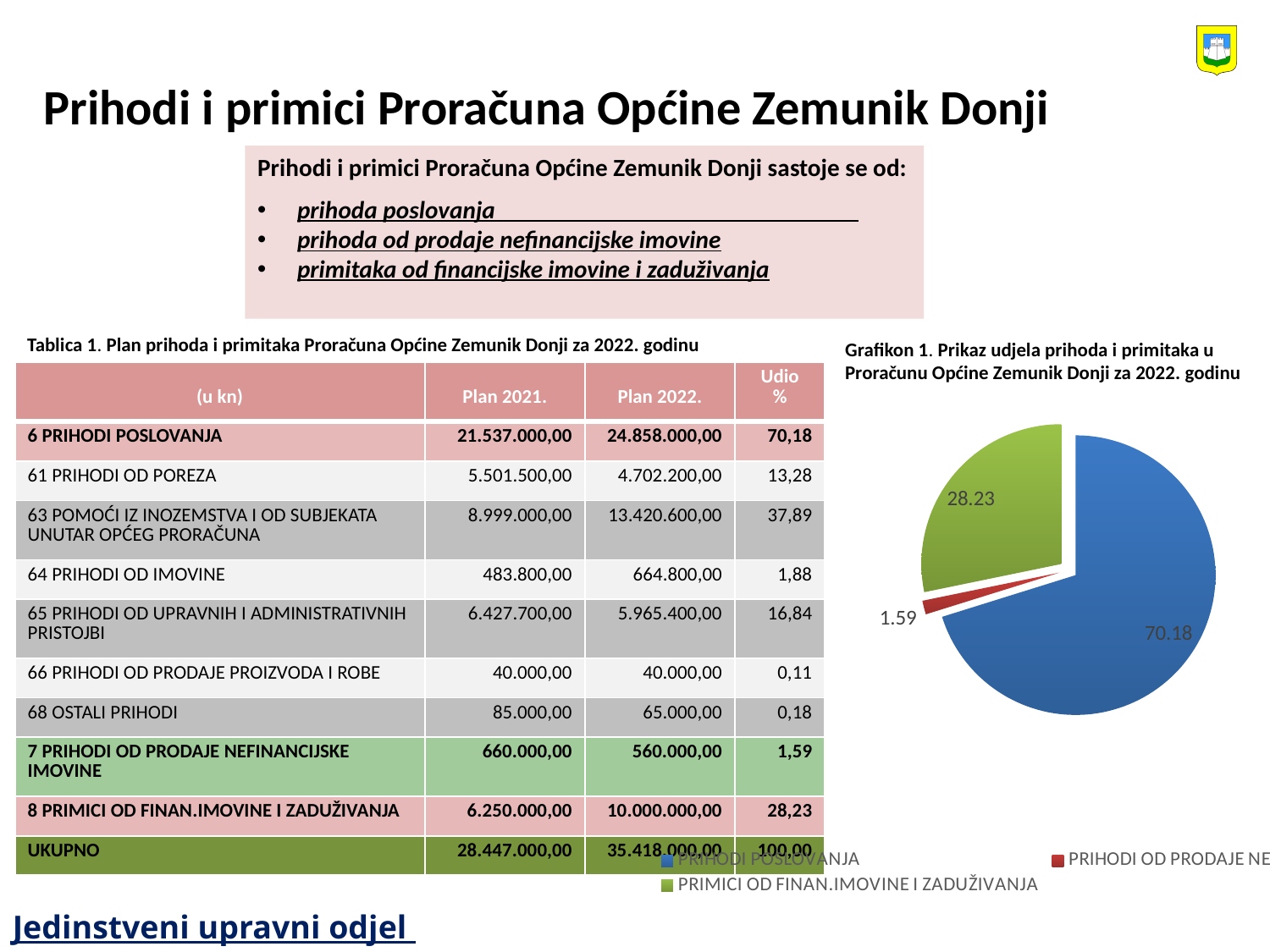
What value is shown on the pie chart for PRIHODI POSLOVANJA? 70.18 What colour is the PRIHODI POSLOVANJA slice in the pie chart? blue In the pie chart, which is larger: PRIHODI POSLOVANJA or PRIMICI OD FINAN.IMOVINE I ZADUŽIVANJA? PRIHODI POSLOVANJA How many slices does the pie chart have? 3 What value is shown on the pie chart for PRIMICI OD FINAN.IMOVINE I ZADUŽIVANJA? 28.23 What is the value of the smallest slice in the pie chart? 1.59 What kind of chart is Grafikon 1 on the slide? pie chart Is the pie chart value for PRIMICI OD FINAN.IMOVINE I ZADUŽIVANJA greater or less than 50? less Which category has the largest slice in the pie chart? PRIHODI POSLOVANJA How many entries does the legend of the pie chart list? 3 What is the title of the pie chart? Grafikon 1. Prikaz udjela prihoda i primitaka u Proračunu Općine Zemunik Donji za 2022. godinu What is the difference between the pie chart values for PRIHODI POSLOVANJA and PRIMICI OD FINAN.IMOVINE I ZADUŽIVANJA? 41.95